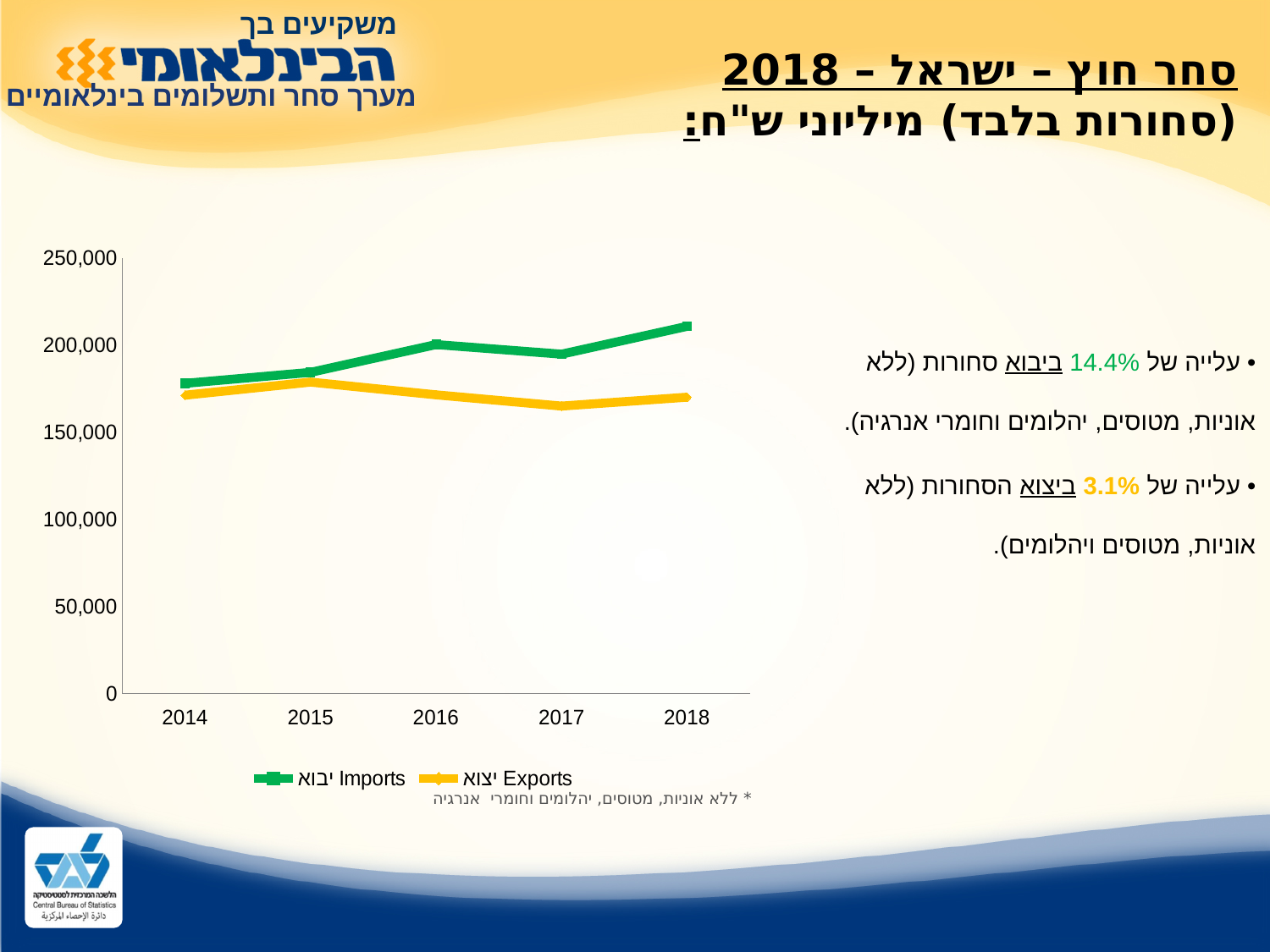
How many series does the chart's legend list? 2 What colour is the Imports (יבוא) line in the chart? green How many years are plotted along the x axis of the chart? 5 Is the value for Imports (יבוא) in 2018 greater or less than 200,000? greater In 2017, which is larger: Imports (יבוא) or Exports (יצוא)? Imports (יבוא) Is the value for Exports (יצוא) in 2018 greater or less than 200,000? less In which year is the Imports (יבוא) line at its highest? 2018 Does the Imports (יבוא) line rise or fall overall from 2014 to 2018? rise Is the value for Imports (יבוא) in 2014 greater or less than 200,000? less In which year is the Imports (יבוא) line at its lowest? 2014 What kind of chart is shown on the slide? line chart